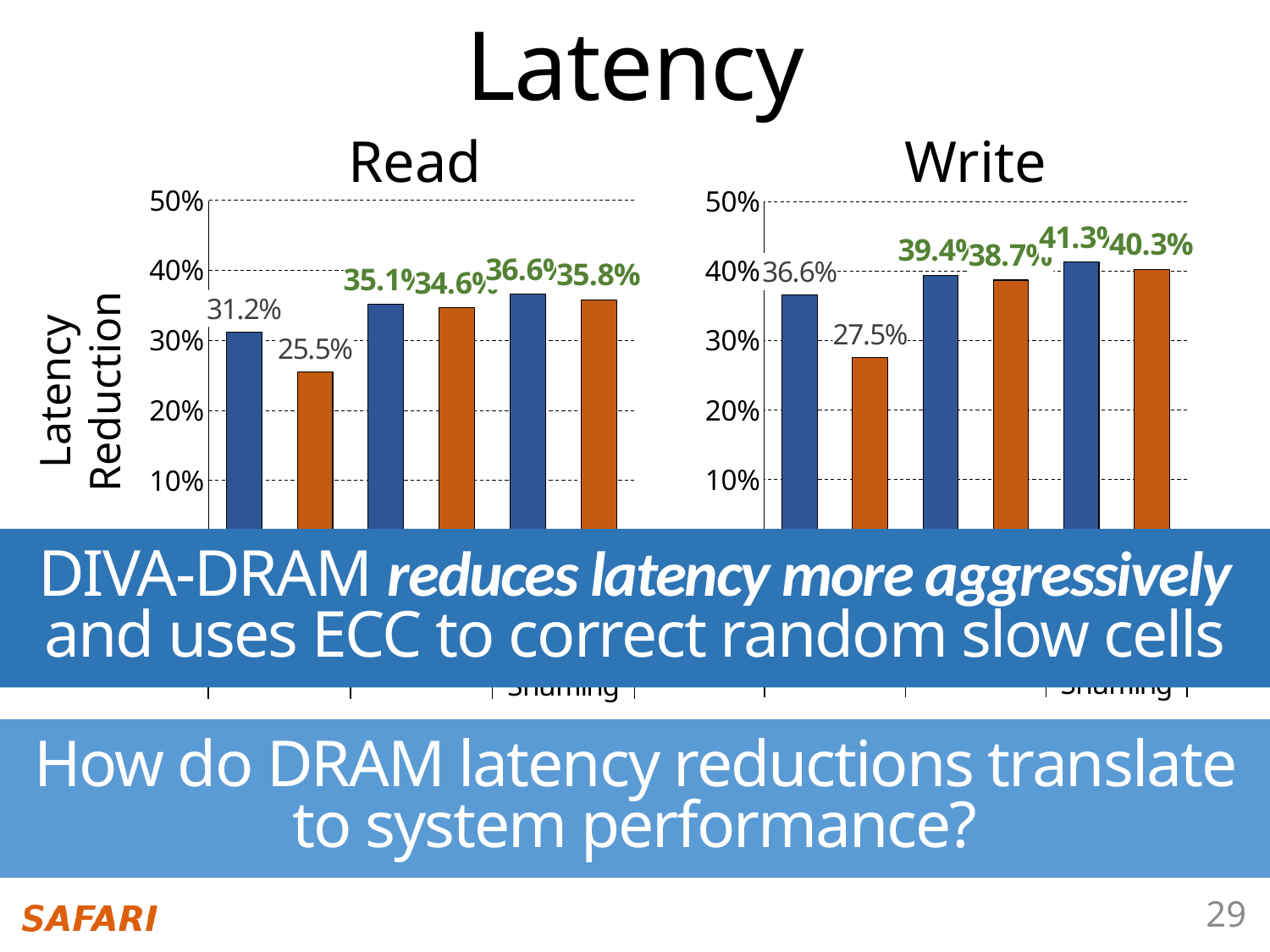
In the Read chart, what is the value of the leftmost bar? 31.2% In the Read chart, what is the difference between the first bar (31.2%) and the second bar (25.5%)? 5.7 percentage points In the Read chart, what is the highest value shown? 36.6% In the Write chart, what is the value of the second bar from the left? 27.5% In the Write chart, what is the lowest value shown? 27.5% In the Write chart, which is larger: the fifth bar from the left or the sixth bar from the left? the fifth bar (41.3%) How many bars are plotted in the Write chart? 6 What kind of chart is the Read chart? bar chart In the Write chart, is the value of the leftmost bar greater or less than 30%? greater What is the y-axis label shared by the two charts? Latency Reduction In the Write chart, what is the highest value shown? 41.3% In the Read chart, what is the lowest value shown? 25.5%